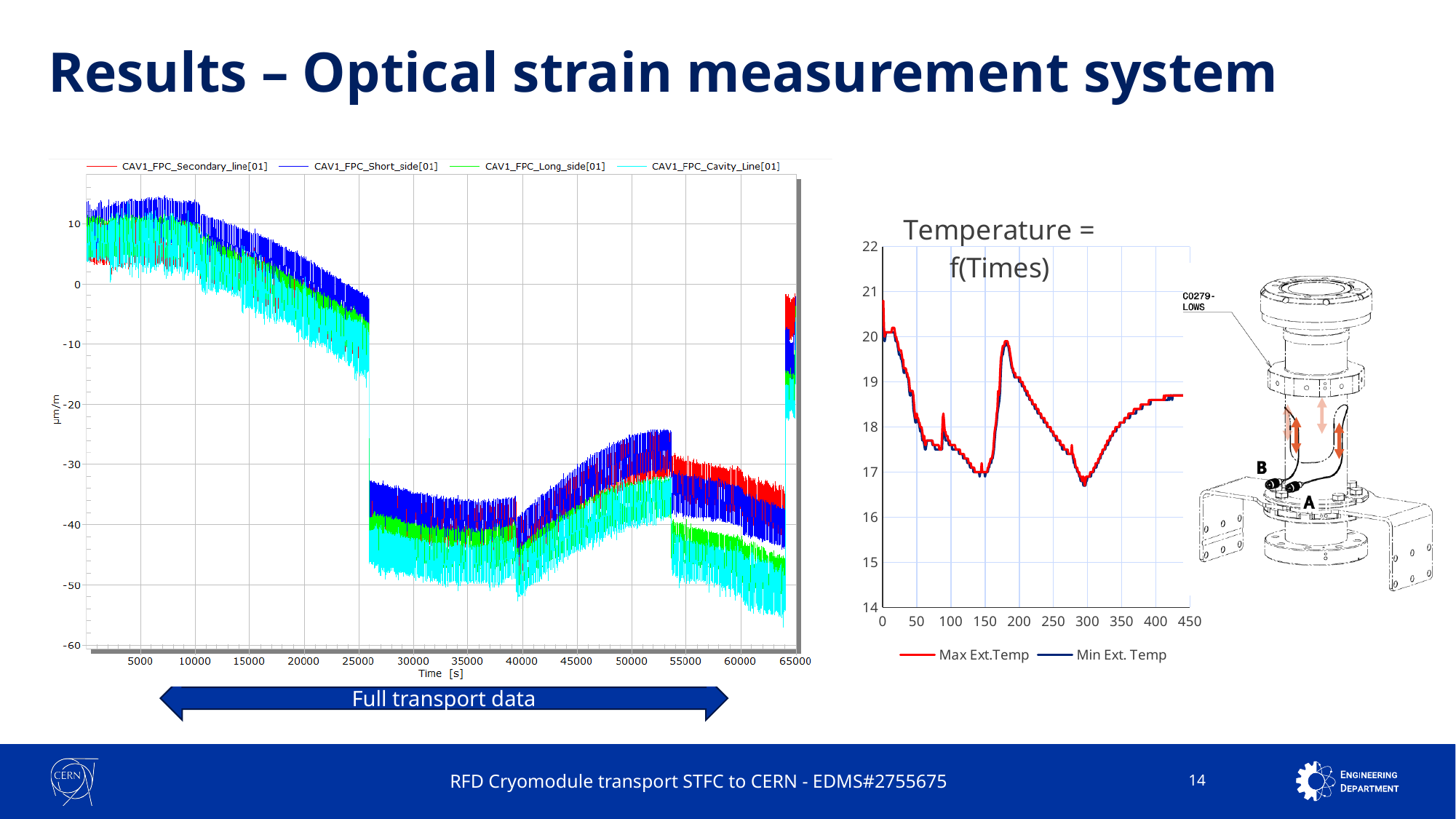
How many series does the legend of the left chart list? 4 In the 'Temperature = f(Times)' chart, do the values rise or fall between 200 and 300 on the x axis? fall In the left chart, is the value for CAV1_FPC_Short_side[01] at 5000 s greater or less than 0? greater In the left chart, do the values rise or fall between 10000 s and 25000 s? fall In the 'Temperature = f(Times)' chart, is the value for Max Ext.Temp at 0 greater or less than 20? greater In the left chart, is the value for CAV1_FPC_Cavity_Line[01] at 35000 s greater or less than -40? less What kind of chart is the large chart on the left of the slide? line chart What kind of chart is the 'Temperature = f(Times)' chart? line chart How many series does the legend of the 'Temperature = f(Times)' chart list? 2 What is the unit shown on the y axis of the left chart? µm/m What are the two legend entries of the 'Temperature = f(Times)' chart? Max Ext.Temp and Min Ext. Temp